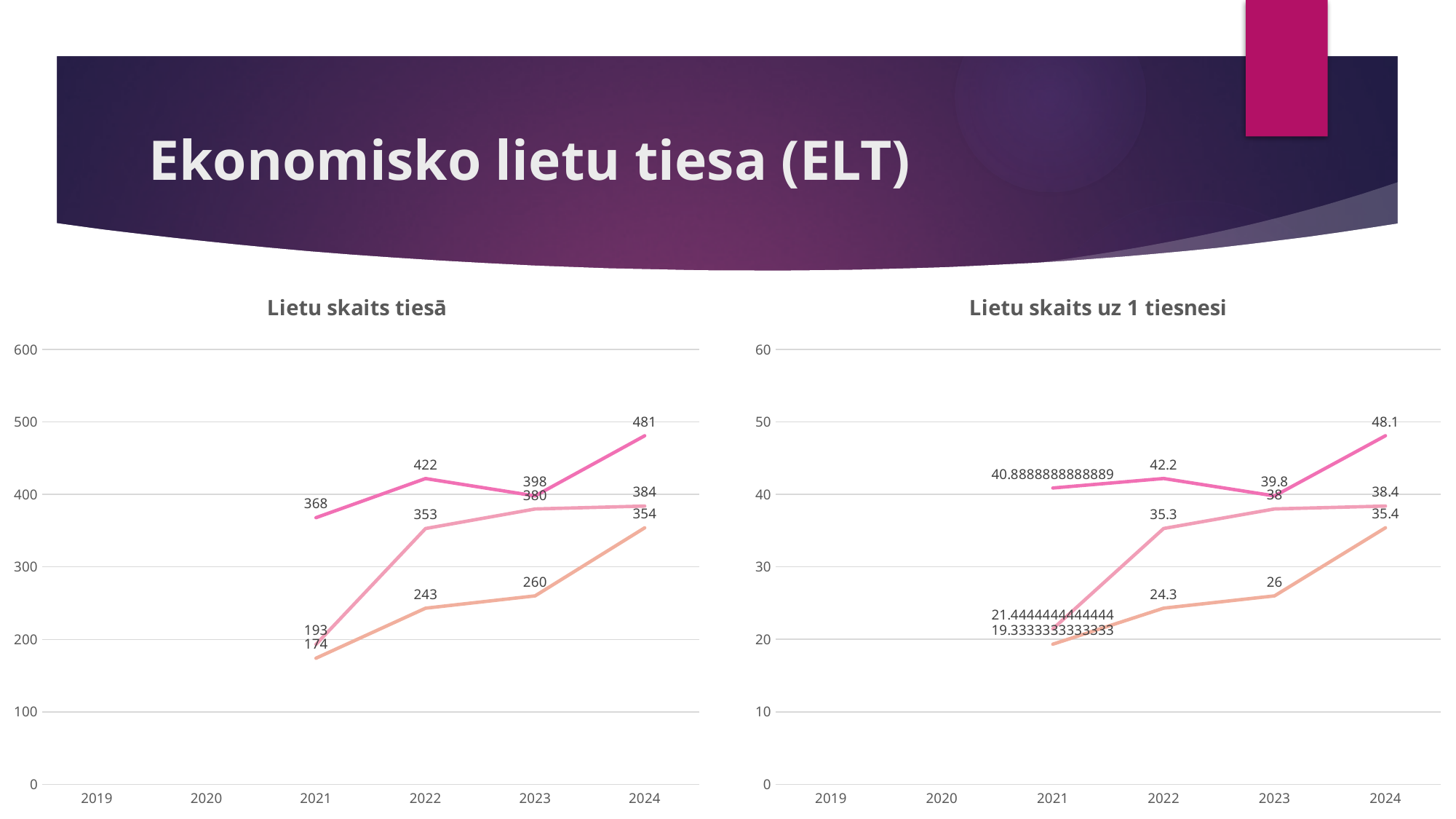
What type of chart is "Lietu skaits tiesā"? line chart In the "Lietu skaits uz 1 tiesnesi" chart, what is the value of the top (dark pink) line in 2024? 48.1 In the "Lietu skaits tiesā" chart, what is the lowest value labelled on the bottom (orange) line? 174 How many line series are plotted in the "Lietu skaits uz 1 tiesnesi" chart? 3 In the "Lietu skaits tiesā" chart, how many years on the x axis have plotted data points? 4 In the "Lietu skaits tiesā" chart, what is the highest value shown on the top (dark pink) line? 481 In the "Lietu skaits tiesā" chart, what is the difference between the top line's 2024 value (481) and its 2023 value (398)? 83 In the "Lietu skaits tiesā" chart, which year has the larger value on the bottom (orange) line, 2022 or 2024? 2024 In the "Lietu skaits uz 1 tiesnesi" chart, is the top line's 2021 value greater or less than 40? greater In the "Lietu skaits tiesā" chart, what is the value of the top (dark pink) line in 2022? 422 In the "Lietu skaits uz 1 tiesnesi" chart, does the bottom (orange) line rise or fall from 2021 to 2024? rise In the "Lietu skaits uz 1 tiesnesi" chart, what is the value of the middle (light pink) line in 2023? 38